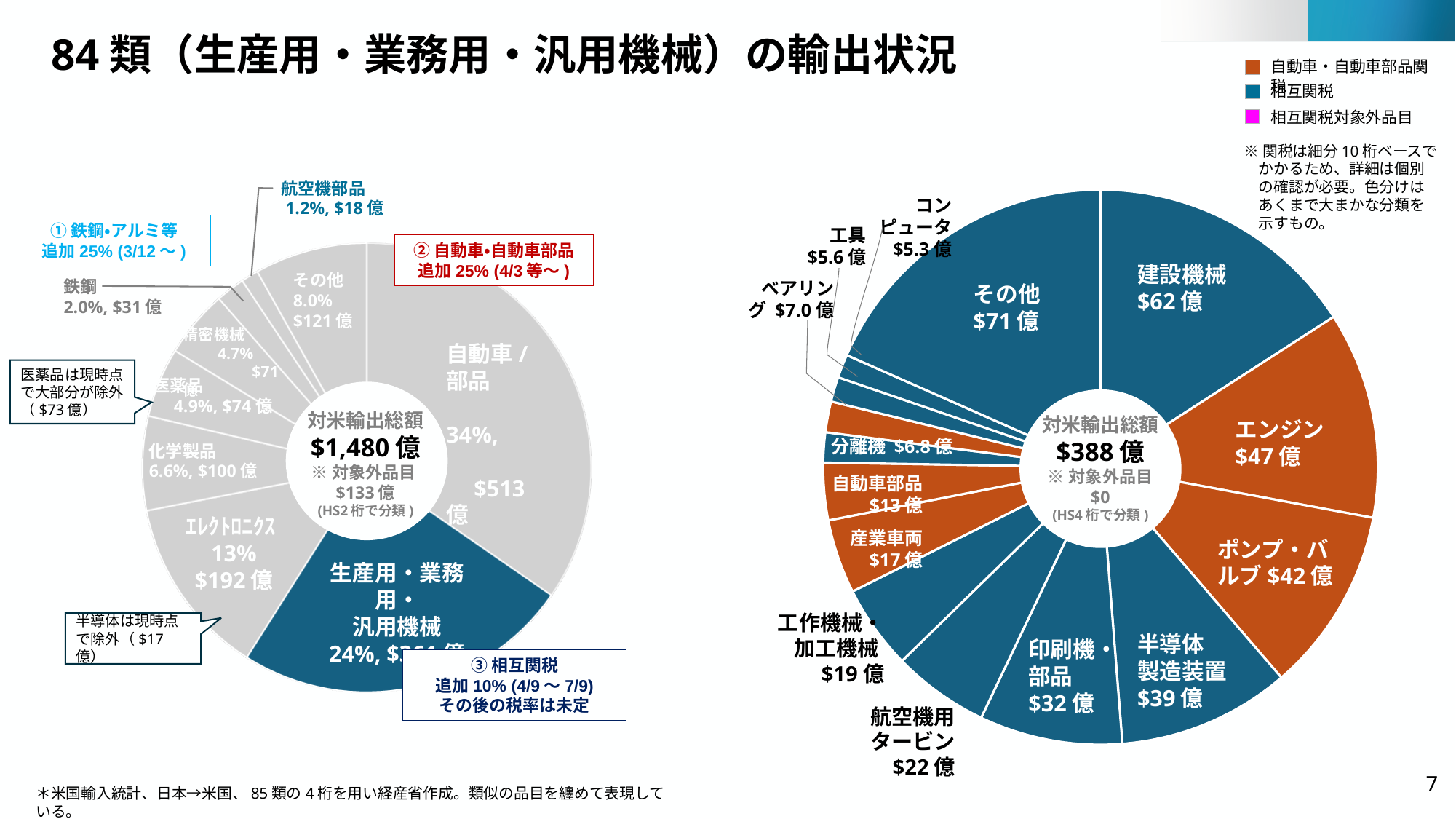
What kind of chart is used on the left side of the slide (対米輸出総額 $1,480億)? Pie chart (donut) In the left chart, what is the value shown for 航空機部品? $18 億 In the right chart, which slice has the largest value? その他 ($71 億) In the right chart, what is the difference between 建設機械 and エンジン? $15 億 In the left chart, what is the export value shown for 自動車/部品? $513 億 In the right chart, which slice has the smallest value? コンピュータ ($5.3 億) In the right chart (対米輸出総額 $388億), what is the value shown for 建設機械? $62 億 In the right chart, which is larger: 半導体製造装置 or 印刷機・部品? 半導体製造装置 How many entries does the legend in the top right of the slide list? 3 In the left chart, what is the total export value to the US shown in the centre? $1,480 億 In the left chart, what is the value shown for エレクトロニクス? $192 億 In the left chart, what share of exports to the US does 自動車/部品 account for? 34%